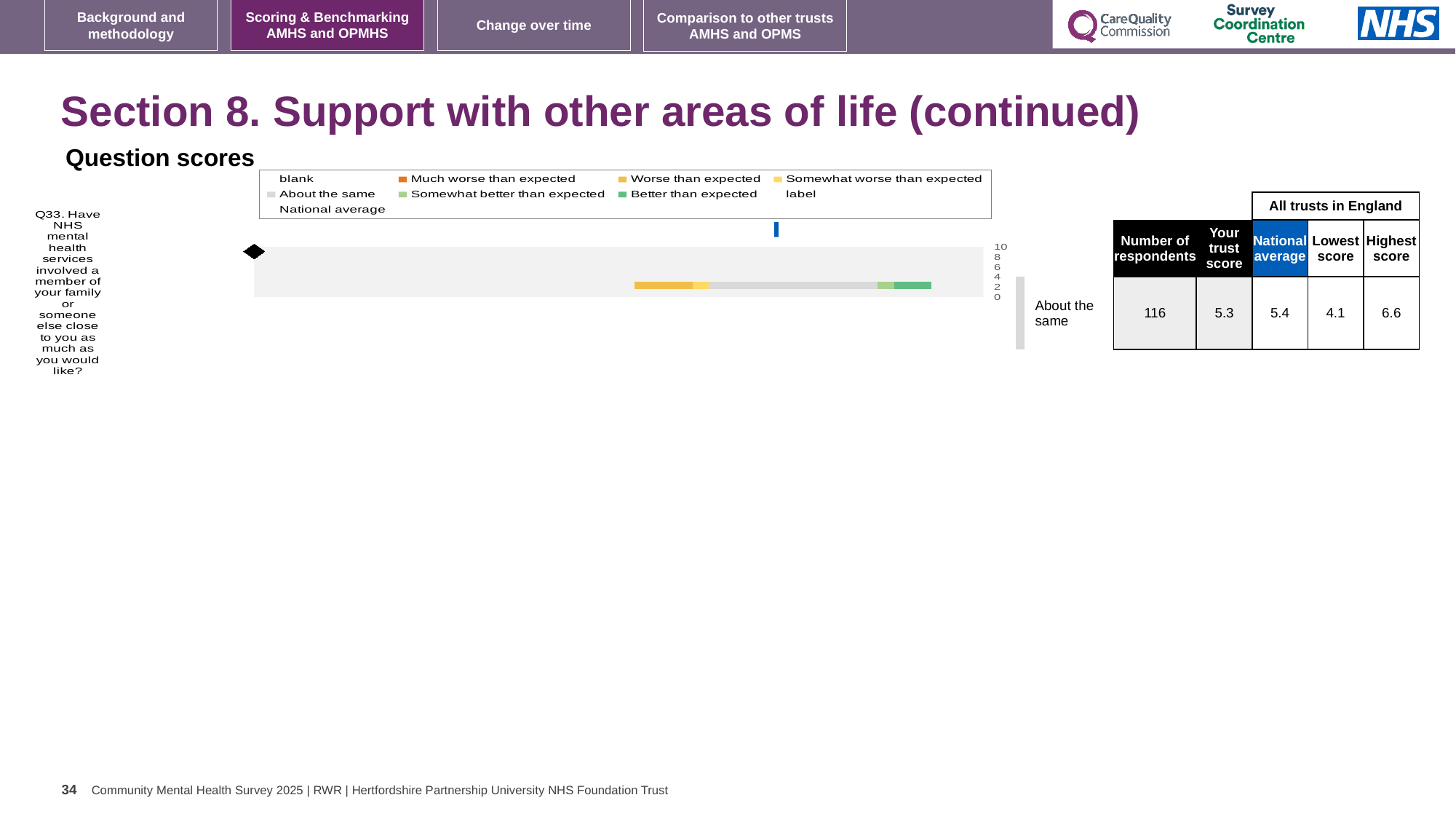
What is the difference between the highest and lowest trust scores for Q33? 2.5 What is the lowest score among all trusts in England for Q33? 4.1 Which is larger for Q33, the trust's score or the national average? national average What kind of chart is used to show the Q33 question score? bar chart What is the trust's score for Q33? 5.3 Which benchmark category does the trust's Q33 score fall into? About the same What is the national average score for Q33? 5.4 Which legend entry is shown in dark green in the question scores chart? Better than expected What is the highest score among all trusts in England for Q33? 6.6 How many questions are plotted in the question scores chart? 1 How many respondents answered Q33? 116 By how much does the national average exceed the trust's score for Q33? 0.1